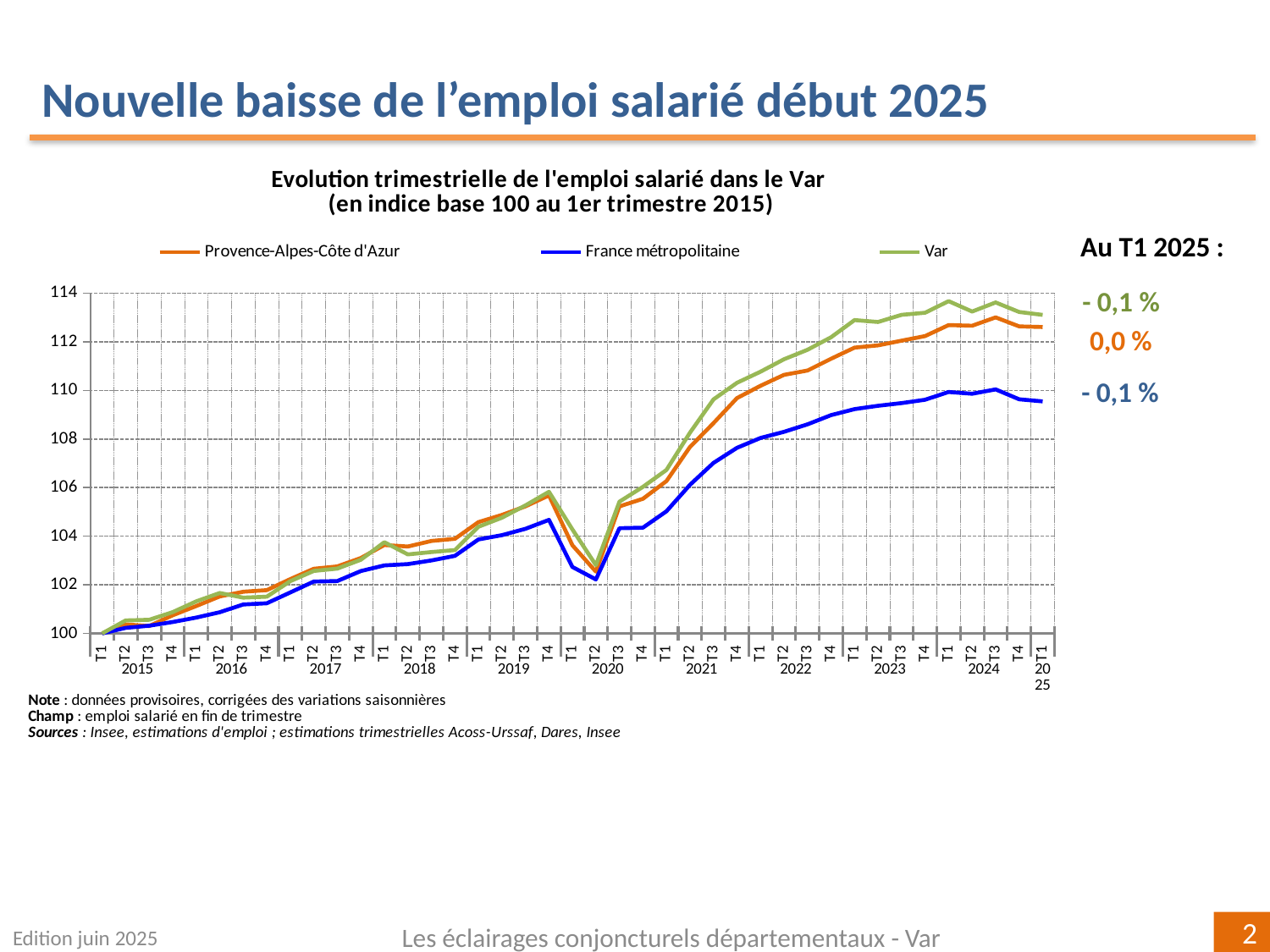
Do the values for Var rise or fall between T4 2019 and T2 2020? fall What kind of chart is shown on the slide? line chart What is the index value of all three series at T1 2015? 100 Which series is drawn in blue? France métropolitaine What quarterly change is shown for Provence-Alpes-Côte d'Azur at T1 2025? 0,0 % How many series does the legend list? 3 What is the title of the chart? Evolution trimestrielle de l'emploi salarié dans le Var (en indice base 100 au 1er trimestre 2015) Is the value for France métropolitaine at T1 2025 greater or less than 110? less What quarterly change is shown for Var at T1 2025? - 0,1 % Is the value for Var at T1 2025 greater or less than 112? greater Which series has the highest index value at T1 2025? Var Which series has the lowest index value at T1 2025? France métropolitaine